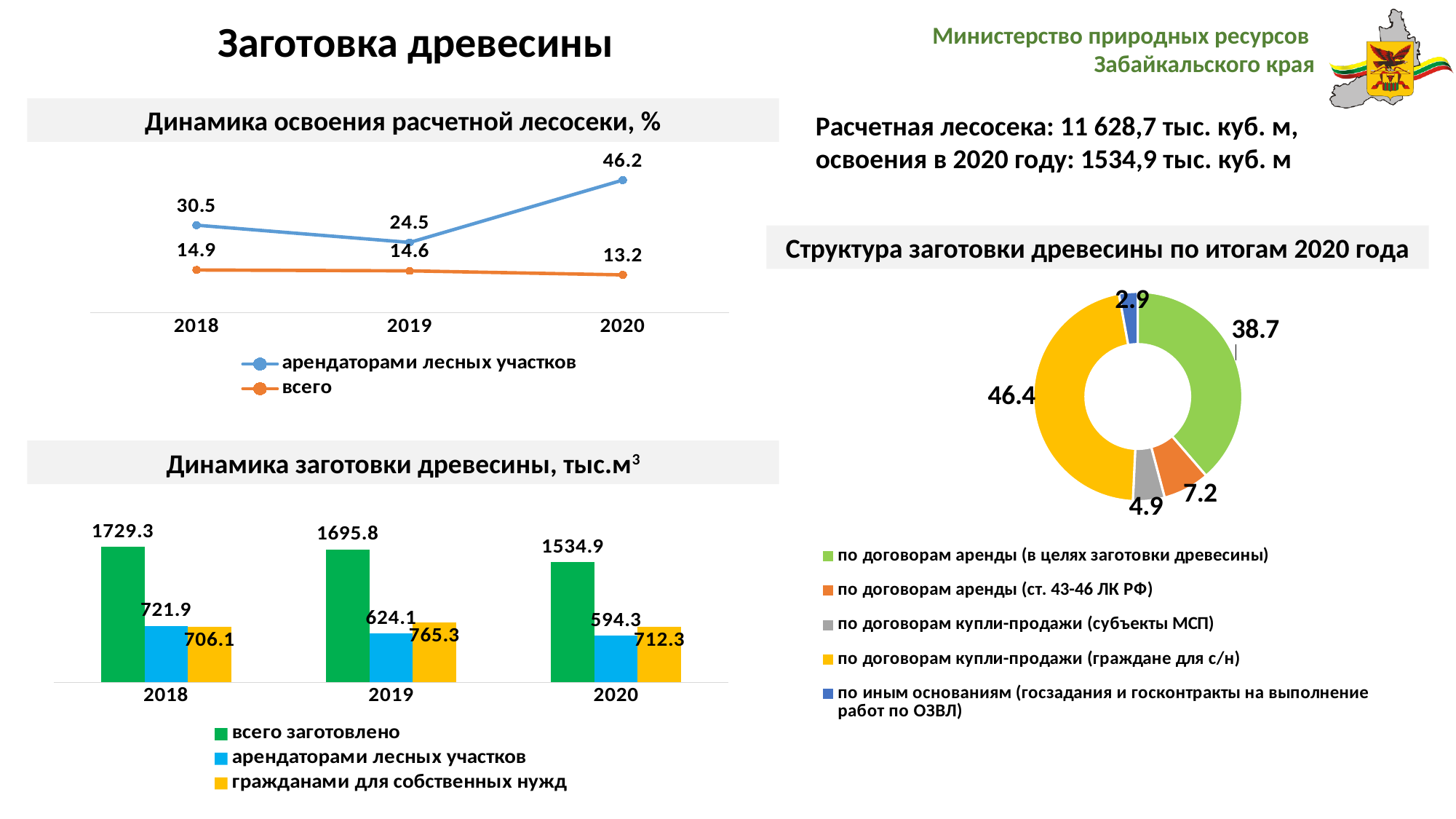
In the chart 'Структура заготовки древесины по итогам 2020 года', which category has the smallest slice? по иным основаниям (госзадания и госконтракты на выполнение работ по ОЗВЛ) In the chart 'Структура заготовки древесины по итогам 2020 года', what is the value for 'по договорам купли-продажи (граждане для с/н)'? 46.4 In the chart 'Динамика освоения расчетной лесосеки, %', what is the value for 'арендаторами лесных участков' in 2020? 46.2 In the chart 'Динамика освоения расчетной лесосеки, %', does the 'всего' series rise or fall from 2019 to 2020? fall In the chart 'Динамика заготовки древесины, тыс.м³', what is the value for 'гражданами для собственных нужд' in 2020? 712.3 In the chart 'Динамика освоения расчетной лесосеки, %', what is the value for 'всего' in 2018? 14.9 What kind of chart is 'Динамика заготовки древесины, тыс.м³'? bar chart In the chart 'Динамика заготовки древесины, тыс.м³', what is the value for 'всего заготовлено' in 2019? 1695.8 In the chart 'Динамика освоения расчетной лесосеки, %', in which year is the 'арендаторами лесных участков' value lowest? 2019 In the chart 'Динамика заготовки древесины, тыс.м³', which is larger in 2019: 'арендаторами лесных участков' or 'гражданами для собственных нужд'? гражданами для собственных нужд In the chart 'Динамика освоения расчетной лесосеки, %', how many series does the legend list? 2 In the chart 'Динамика заготовки древесины, тыс.м³', what is the difference between 'всего заготовлено' in 2018 and in 2020? 194.4